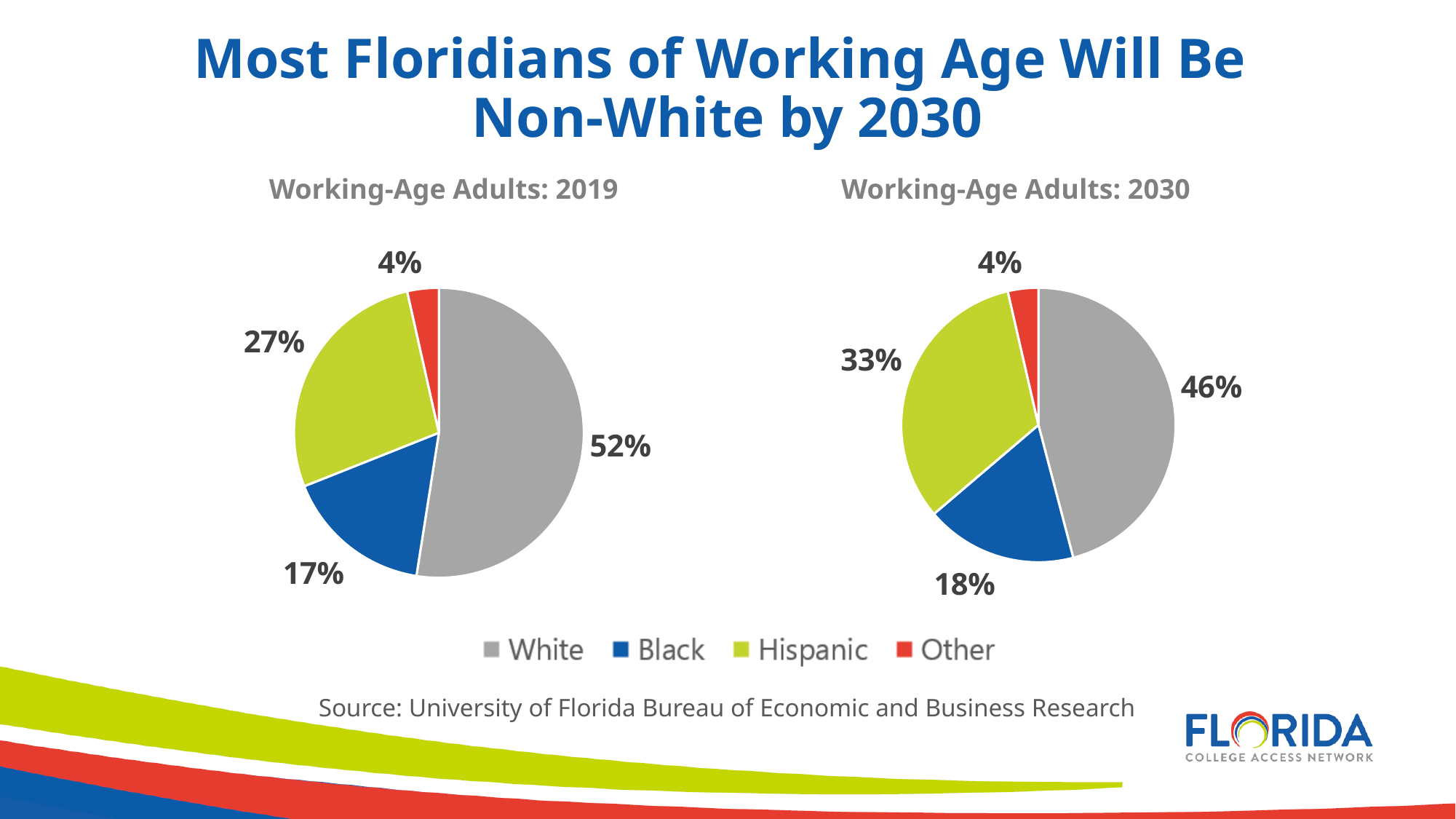
Which colour represents Hispanic in the pie charts? Green In the 'Working-Age Adults: 2030' pie chart, which group has the smallest share? Other In the 'Working-Age Adults: 2019' pie chart, what share is Black? 17% In the 'Working-Age Adults: 2030' pie chart, which is larger, the Black share or the Hispanic share? Hispanic How much larger is the Hispanic share in the 'Working-Age Adults: 2030' chart than in the 'Working-Age Adults: 2019' chart? 6 percentage points In the 'Working-Age Adults: 2019' pie chart, which group has the largest share? White How many groups does the legend list? 4 In the 'Working-Age Adults: 2030' pie chart, what share is White? 46% What type of chart is used for 'Working-Age Adults: 2030'? Pie chart In the 'Working-Age Adults: 2019' pie chart, what share is White? 52% In the 'Working-Age Adults: 2030' pie chart, what share is Hispanic? 33% How many slices does the 'Working-Age Adults: 2019' pie chart have? 4